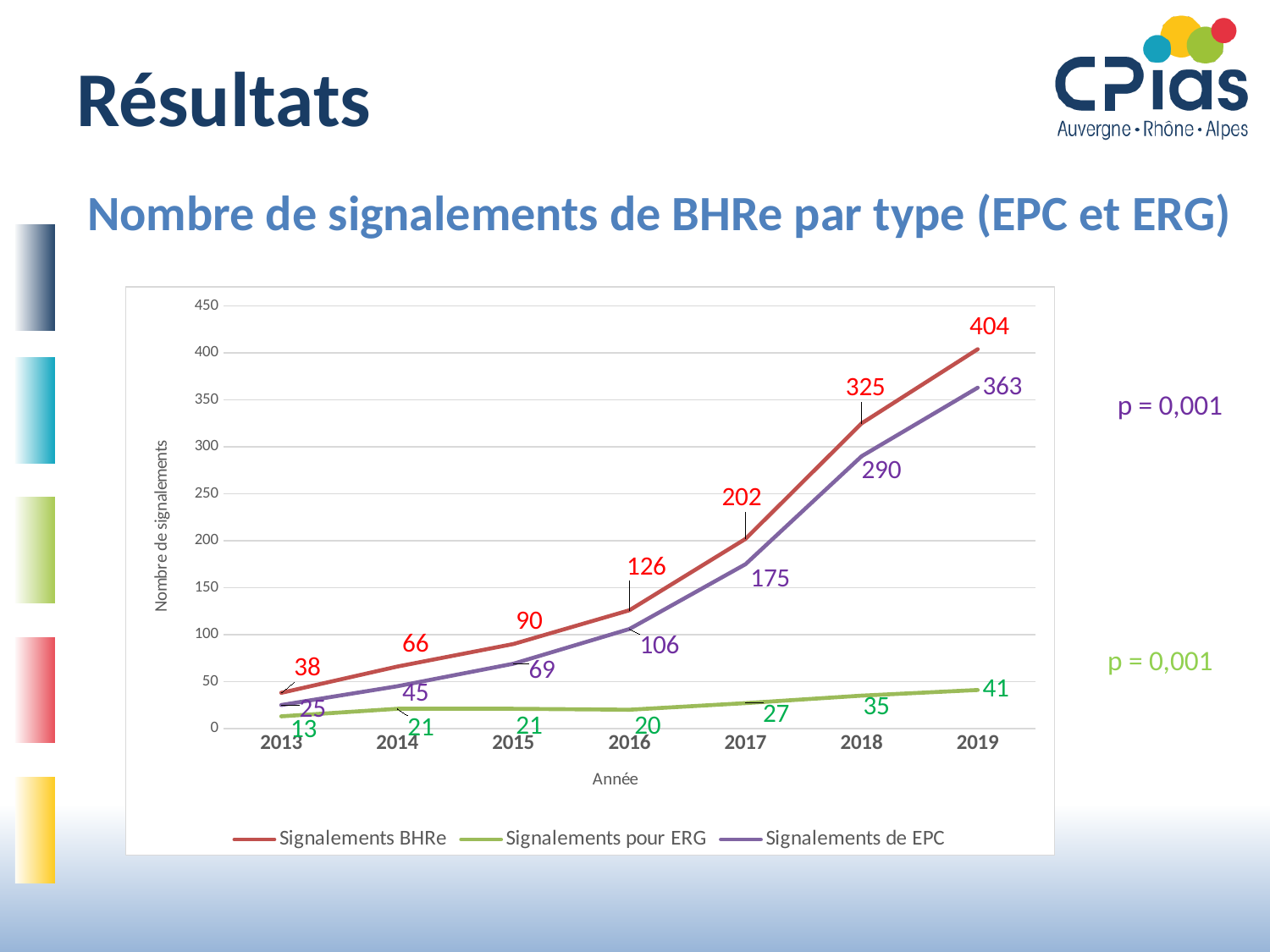
How many series does the legend list? 3 In which year is Signalements BHRe highest? 2019 Which is larger in 2016: Signalements de EPC or Signalements pour ERG? Signalements de EPC Does Signalements de EPC rise or fall from 2013 to 2019? Rise What is the value of Signalements pour ERG in 2013? 13 What is the label of the y axis? Nombre de signalements What is the difference between Signalements BHRe and Signalements de EPC in 2018? 35 How many years are shown on the x axis? 7 What is the value of Signalements de EPC in 2017? 175 What kind of chart is shown? Line chart What is the value of Signalements BHRe in 2019? 404 In which year is Signalements pour ERG lowest? 2013